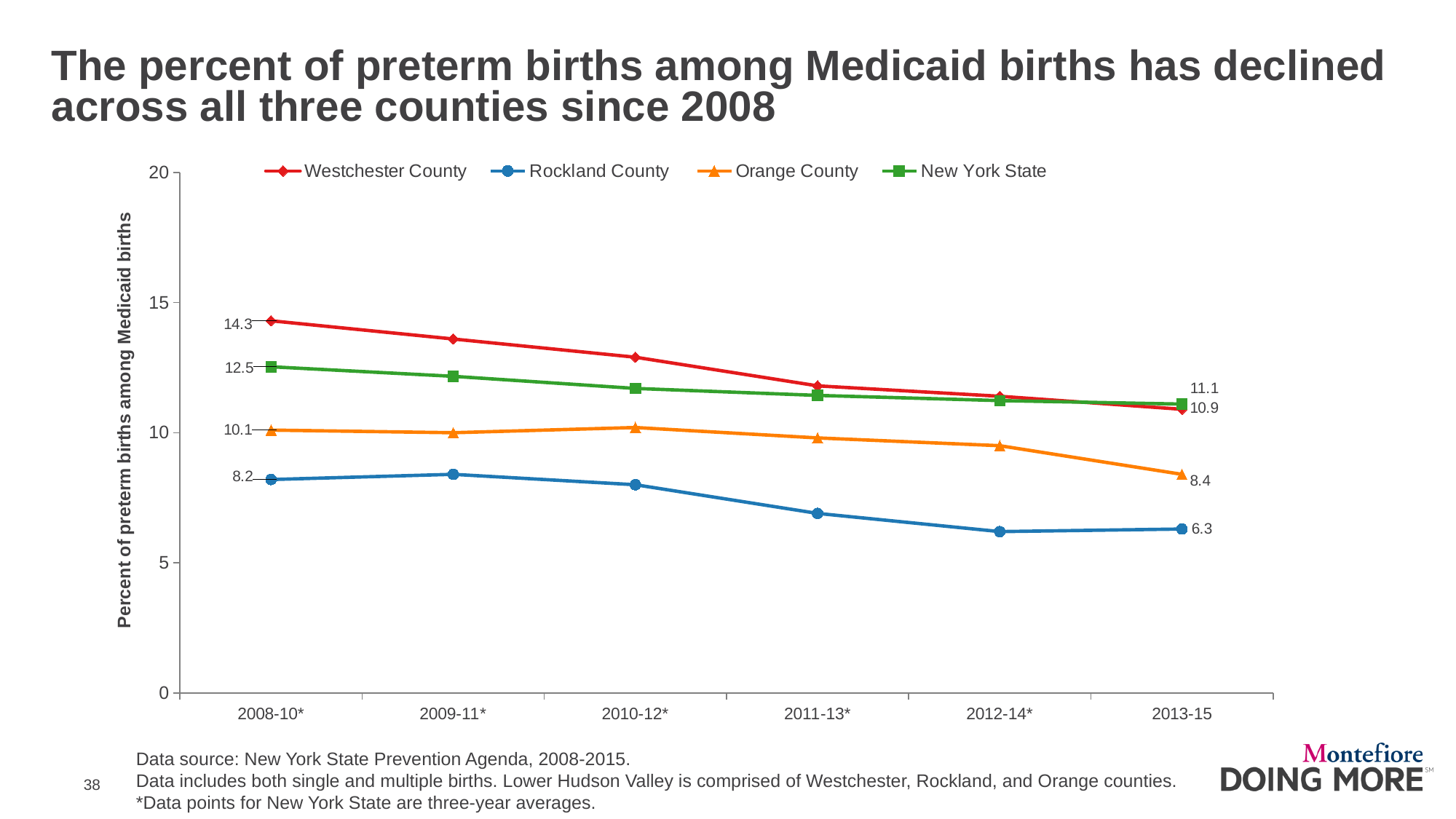
Is the value for Rockland County in 2011-13 greater or less than 10? less What was the percent of preterm births among Medicaid births for Rockland County in 2013-15? 6.3 What was the percent of preterm births among Medicaid births for New York State in 2008-10? 12.5 By how much did the Westchester County value decline from 2008-10 to 2013-15? 3.4 How many time periods are shown on the x axis? 6 Which series had the lowest value in 2013-15? Rockland County Which is larger in 2013-15: the value for New York State or the value for Westchester County? New York State What type of chart is shown on the slide? Line chart What was the percent of preterm births among Medicaid births for Westchester County in 2008-10? 14.3 What was the percent of preterm births among Medicaid births for Orange County in 2013-15? 8.4 Which series had the highest value in 2008-10? Westchester County How many series does the legend list? 4